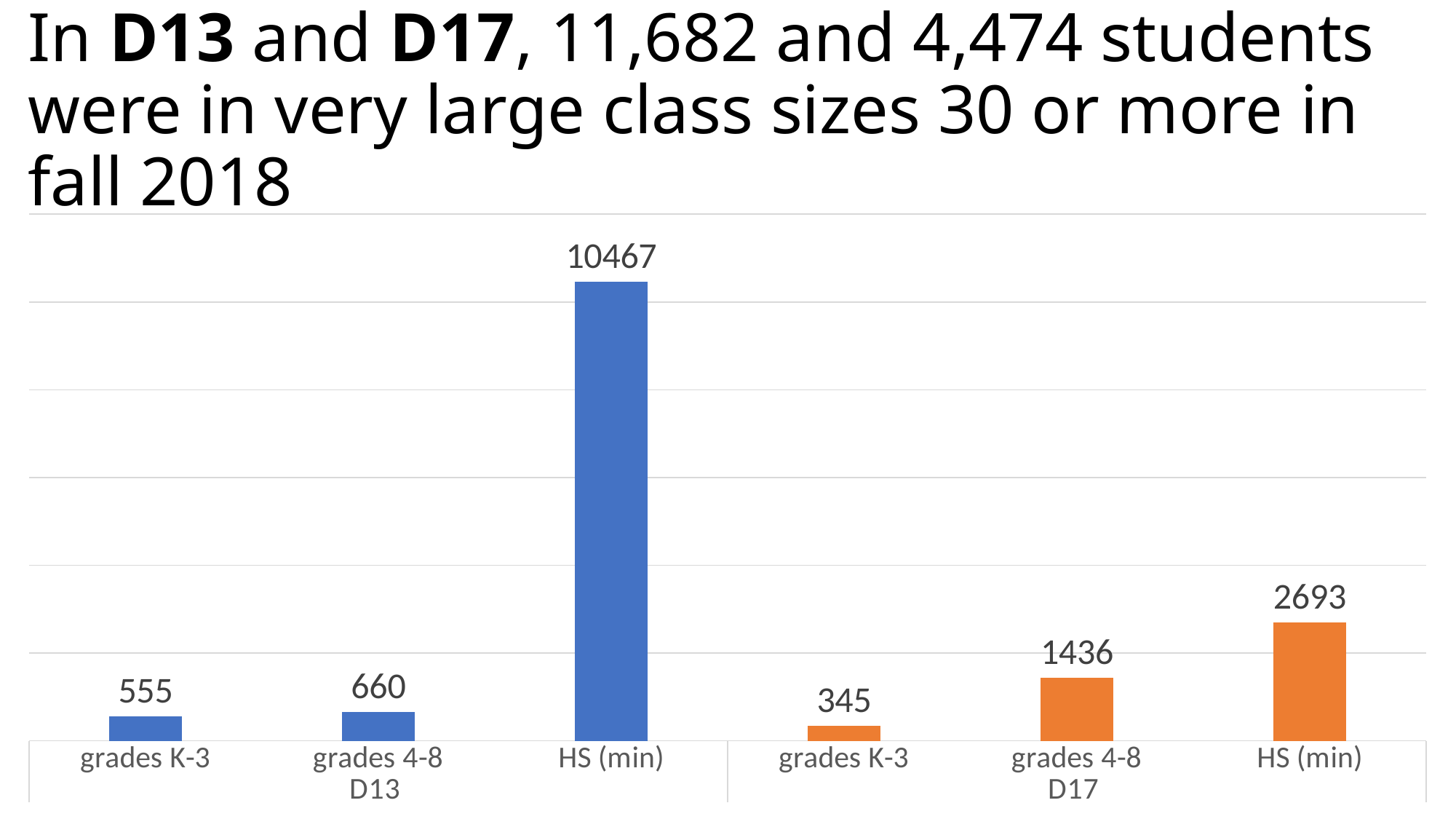
What kind of chart is shown on the slide? bar chart What is the difference between grades 4-8 in D17 and grades 4-8 in D13? 776 What is the value for HS (min) in D13? 10467 What is the value for grades K-3 in D17? 345 Which bar has the lowest value on the chart? grades K-3 in D17 Which bar has the highest value on the chart? HS (min) in D13 What is the value for HS (min) in D17? 2693 How many bars are plotted on the chart? 6 What is the value for grades 4-8 in D13? 660 What is the difference between the HS (min) values for D13 and D17? 7774 What is the total of the three D17 bars? 4474 Which is larger: grades K-3 in D13 or grades K-3 in D17? grades K-3 in D13